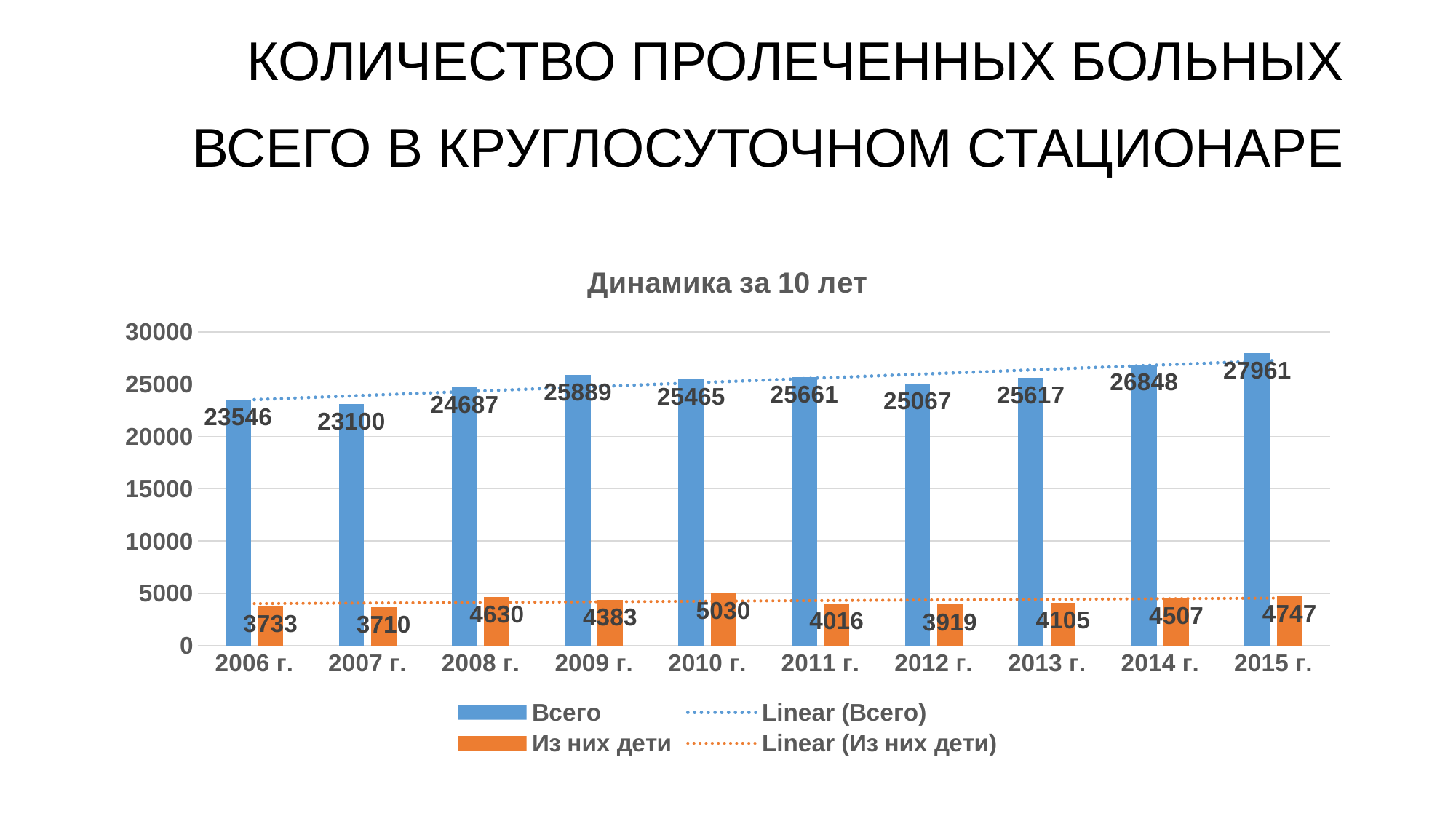
Which is larger, the Из них дети value for 2010 г. or for 2011 г.? 2010 г. What kind of chart is shown on the slide? bar chart Which year has the highest Всего value? 2015 г. What is the value of Из них дети for 2008 г.? 4630 Which year has the lowest Из них дети value? 2007 г. How many entries does the legend list? 4 What is the difference between the Всего values for 2015 г. and 2014 г.? 1113 How many years are shown on the x axis? 10 Is the Всего value for 2007 г. greater or less than 25000? less What is the title of the chart? Динамика за 10 лет What is the value of Всего for 2010 г.? 25465 Does the Всего series generally rise or fall from 2006 г. to 2015 г.? rise